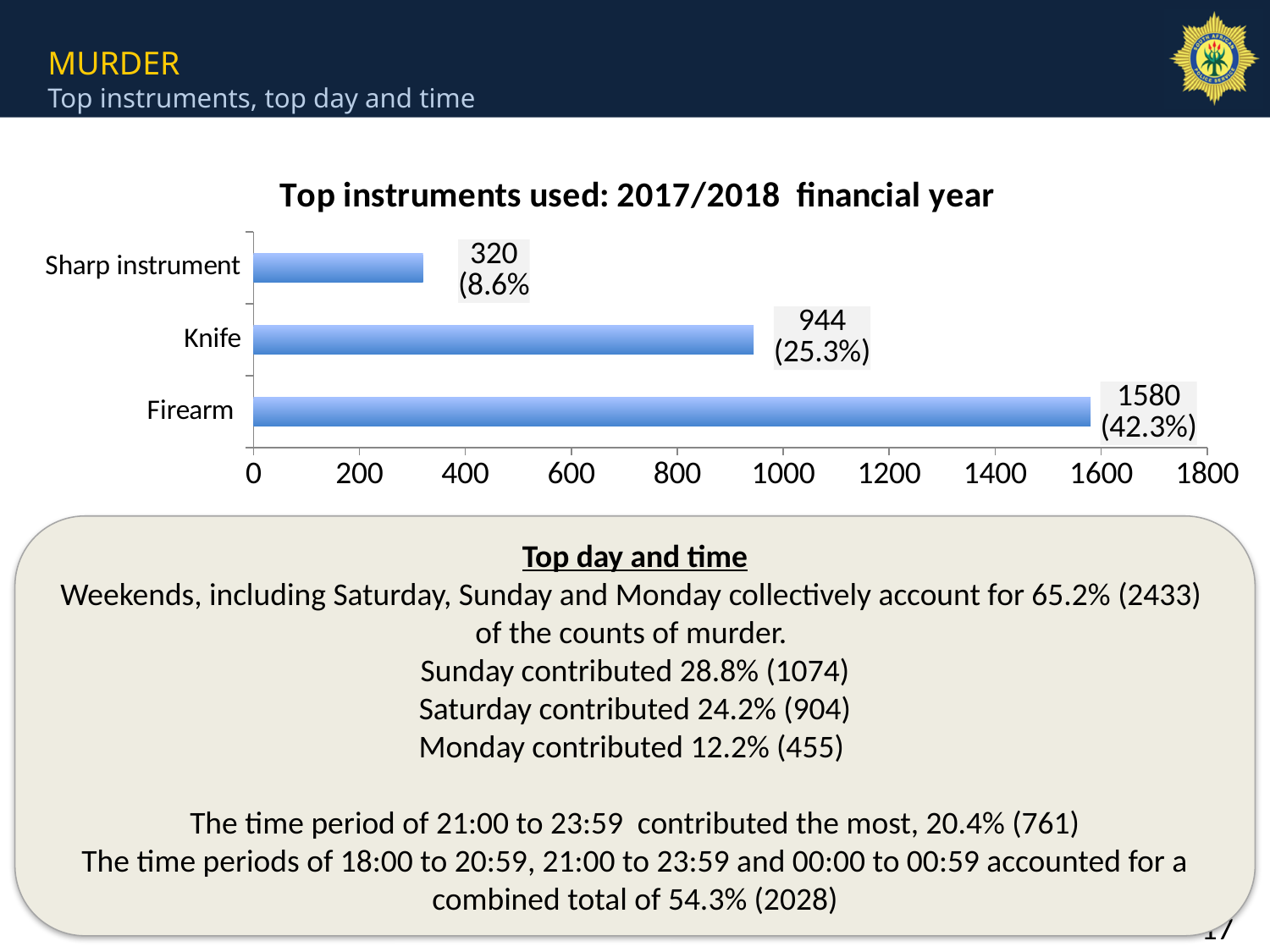
What is the difference between the values for Knife and Sharp instrument? 624 Which is larger, the value for Knife or the value for Sharp instrument? Knife What is the value for Firearm in the 'Top instruments used: 2017/2018 financial year' chart? 1580 How many instrument categories are shown in the chart? 3 What is the value for Sharp instrument in the chart? 320 What is the value for Knife in the chart? 944 What percentage is shown for Knife in the chart? 25.3% What is the title of the chart on the slide? Top instruments used: 2017/2018 financial year Which instrument has the highest value in the chart? Firearm What is the difference between the values for Firearm and Knife? 636 What kind of chart is shown on the slide? Bar chart Which instrument has the lowest value in the chart? Sharp instrument